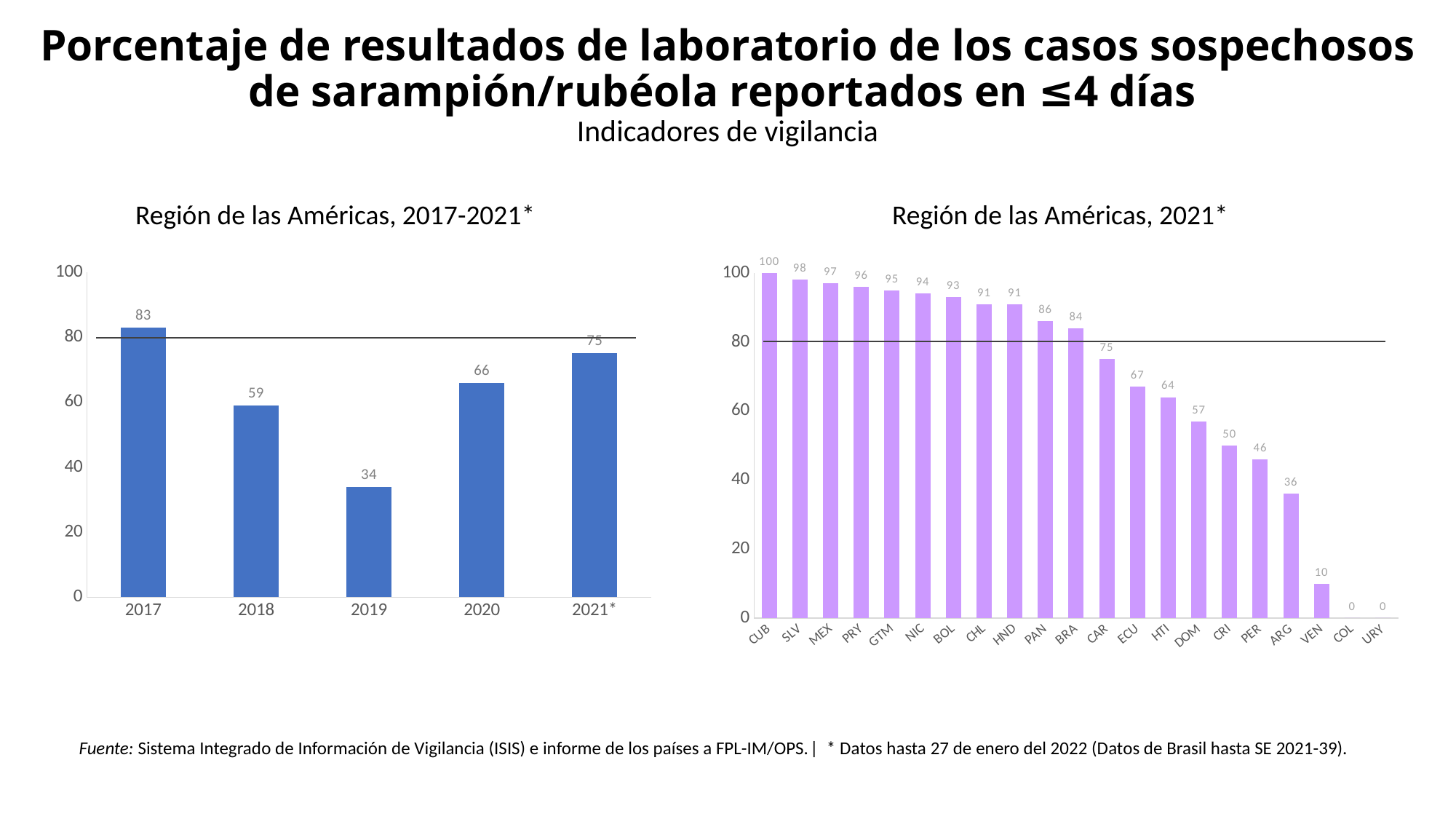
In the chart titled 'Región de las Américas, 2021*', which country has the highest value? CUB What kind of chart is the chart titled 'Región de las Américas, 2021*'? Bar chart In the chart titled 'Región de las Américas, 2021*', how many countries are shown on the x axis? 21 In the chart titled 'Región de las Américas, 2017-2021*', how many years are shown on the x axis? 5 In the chart titled 'Región de las Américas, 2021*', which is larger, the value for ECU or the value for DOM? ECU In the chart titled 'Región de las Américas, 2021*', what is the value for VEN? 10 In the chart titled 'Región de las Américas, 2017-2021*', which year has the highest value? 2017 In the chart titled 'Región de las Américas, 2021*', what is the difference between the values for BRA and CAR? 9 In the chart titled 'Región de las Américas, 2017-2021*', which year has the lowest value? 2019 In the chart titled 'Región de las Américas, 2017-2021*', what is the value for 2019? 34 In the chart titled 'Región de las Américas, 2021*', what is the value for PAN? 86 In the chart titled 'Región de las Américas, 2017-2021*', what is the difference between the values for 2021* and 2020? 9